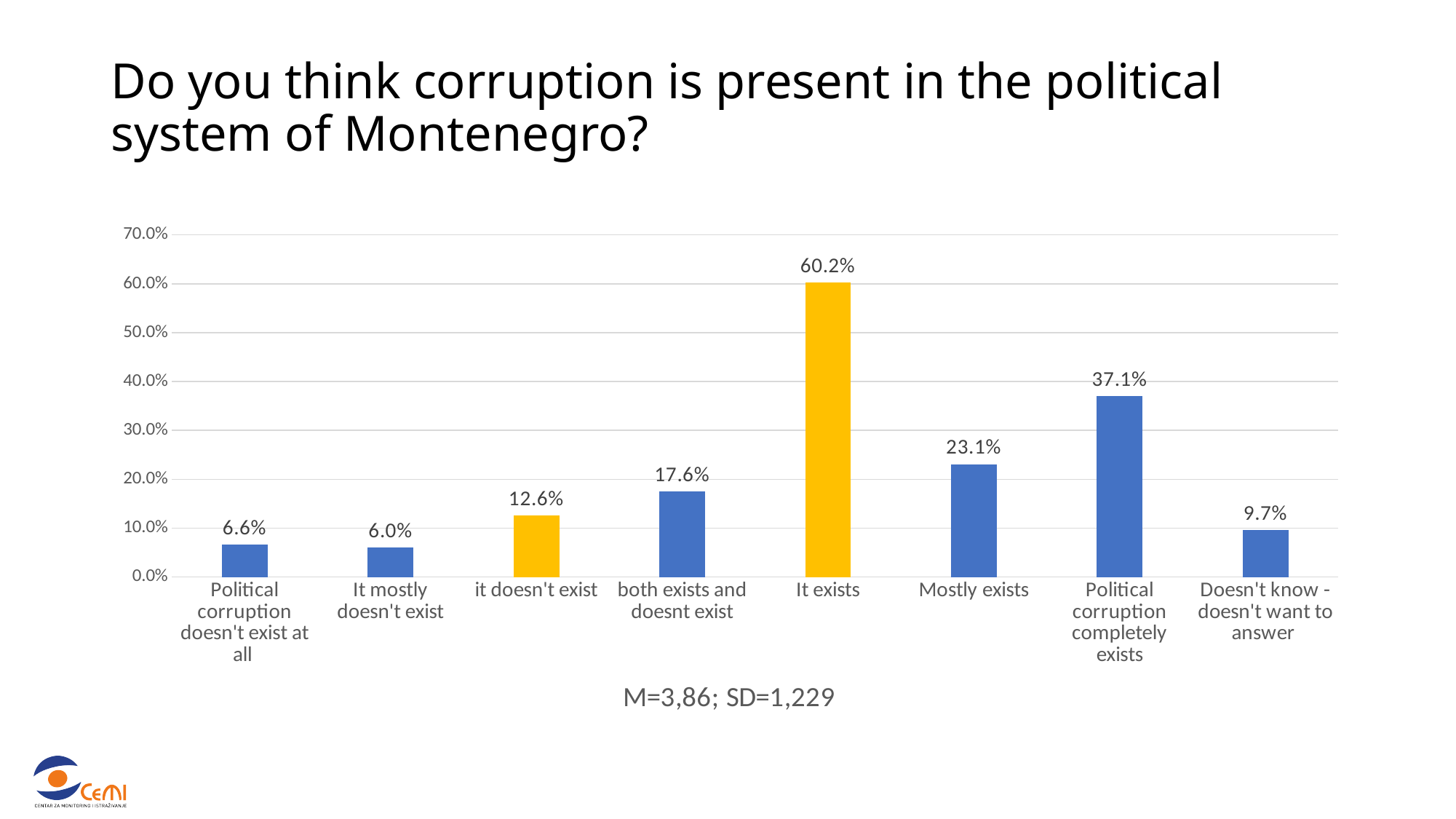
Which is larger, the value for "it doesn't exist" or the value for "both exists and doesnt exist"? both exists and doesnt exist Which category has the lowest value? It mostly doesn't exist What is the difference between "It exists" and "Political corruption completely exists"? 23.1% What mean and standard deviation are printed below the chart? M=3,86; SD=1,229 Which category has the highest value? It exists What kind of chart is shown on the slide? Bar chart What is the value for "Political corruption completely exists"? 37.1% How many categories are shown on the x axis? 8 Is the value for "Mostly exists" greater or less than 20.0%? greater What is the value for "Doesn't know - doesn't want to answer"? 9.7% What is the difference between "Mostly exists" and "both exists and doesnt exist"? 5.5% What percentage of respondents answered "It exists"? 60.2%